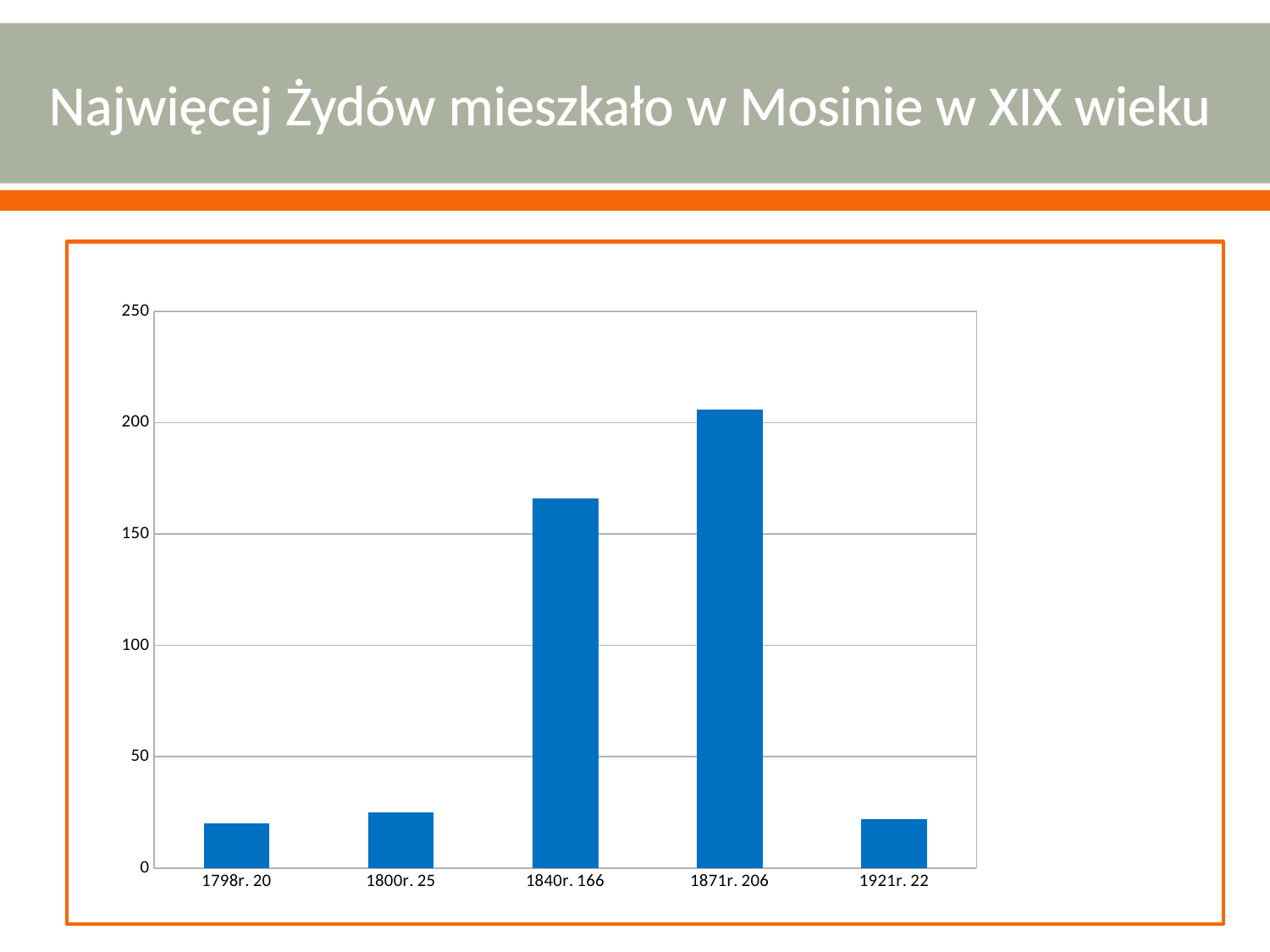
Is the value for 1871 greater or less than 200? greater Which is larger, the value for 1921 or the value for 1800? 1800 What value is shown for 1798 in the chart? 20 How many bars are plotted in the chart? 5 Which year has the highest bar in the chart? 1871r. What is the title of the slide containing the chart? Najwięcej Żydów mieszkało w Mosinie w XIX wieku What is the difference between the values for 1800 and 1798? 5 What is the difference between the values for 1871 and 1840? 40 What value is shown for 1840 in the chart? 166 Which year has the lowest bar in the chart? 1798r. What kind of chart is shown on the slide? bar chart What value is shown for 1871 in the chart? 206